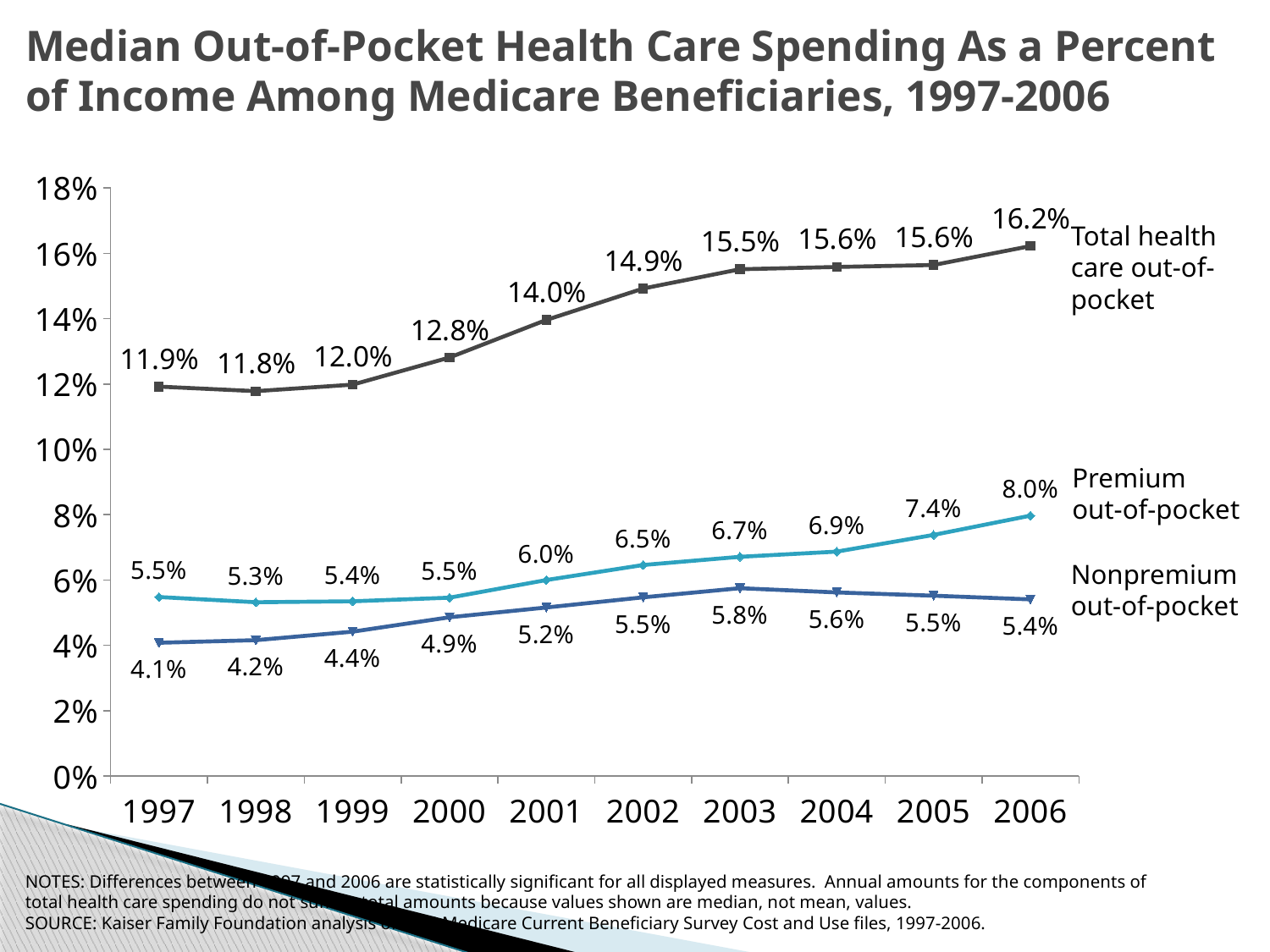
What was the nonpremium out-of-pocket value in 1997? 4.1% How many years are shown on the x axis? 10 In which year was total health care out-of-pocket spending lowest? 1998 In which year was the nonpremium out-of-pocket value highest? 2003 How many series are plotted on the chart? 3 What is the difference between premium out-of-pocket and nonpremium out-of-pocket in 2006? 2.6 percentage points Is the total health care out-of-pocket value for 2003 greater or less than 14%? greater By how many percentage points did total health care out-of-pocket spending change from 1997 to 2006? 4.3 percentage points What was the total health care out-of-pocket spending as a percent of income in 2006? 16.2% Which was larger in 2000, premium out-of-pocket or nonpremium out-of-pocket? Premium out-of-pocket What kind of chart is shown on the slide? Line chart What was the premium out-of-pocket value in 2001? 6.0%